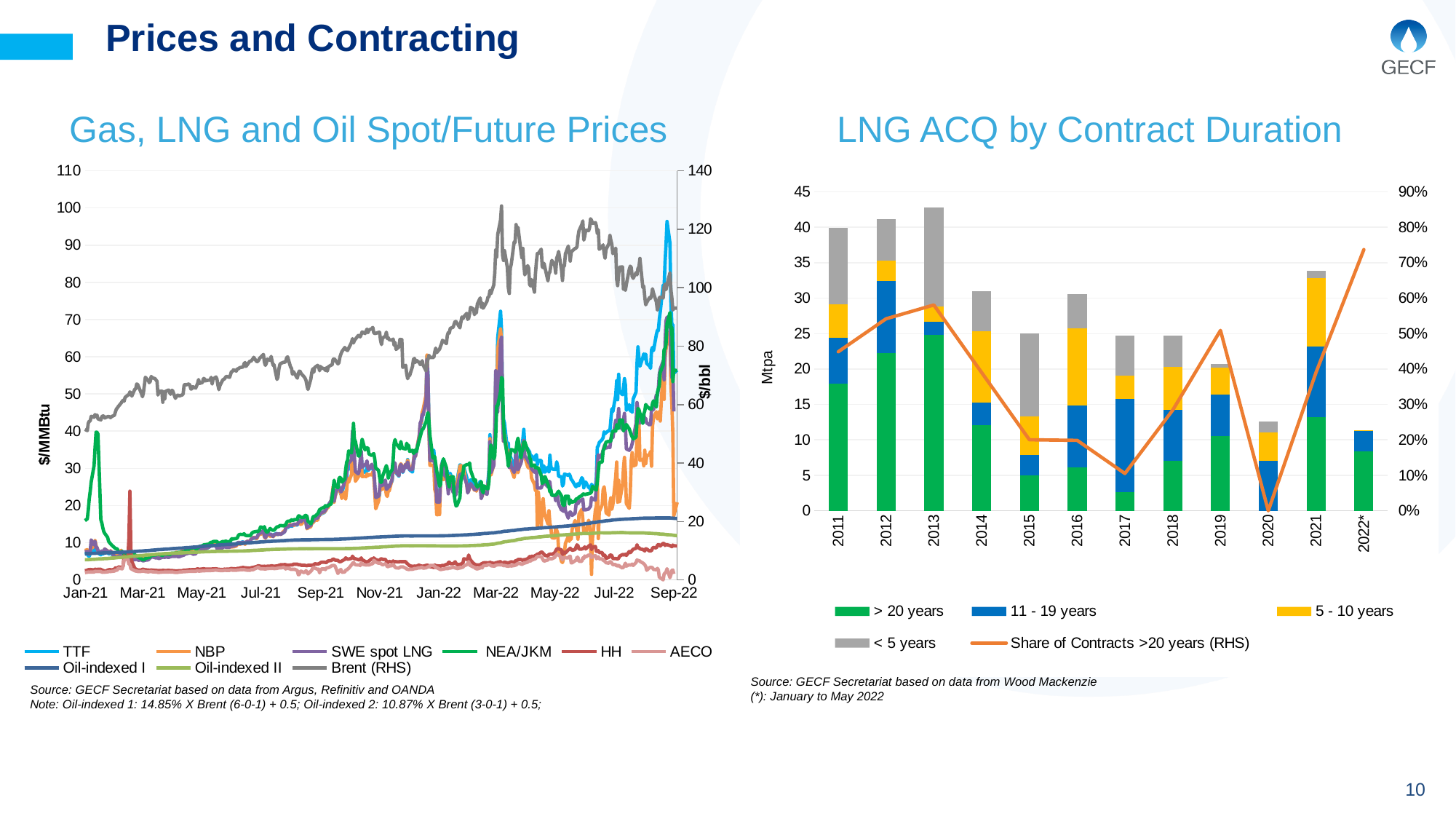
In the 'Gas, LNG and Oil Spot/Future Prices' chart, does the Brent (RHS) series rise or fall between Jan-21 and Mar-22? rise In the 'LNG ACQ by Contract Duration' chart, is the Share of Contracts >20 years (RHS) for 2022* greater or less than 60%? greater How many entries does the legend of the 'LNG ACQ by Contract Duration' chart list? 5 In the 'LNG ACQ by Contract Duration' chart, which year has the tallest stacked bar? 2013 In the 'LNG ACQ by Contract Duration' chart, is the total stacked bar for 2020 greater or less than 15 Mtpa? less What kind of chart is the 'LNG ACQ by Contract Duration' chart? stacked bar chart with a line What kind of chart is the 'Gas, LNG and Oil Spot/Future Prices' chart? line chart How many series does the legend of the 'Gas, LNG and Oil Spot/Future Prices' chart list? 9 In the 'LNG ACQ by Contract Duration' chart, is the total stacked bar for 2013 greater or less than 40 Mtpa? greater In the 'Gas, LNG and Oil Spot/Future Prices' chart, which series is plotted on the right-hand axis? Brent (RHS) How many years are shown on the x axis of the 'LNG ACQ by Contract Duration' chart? 12